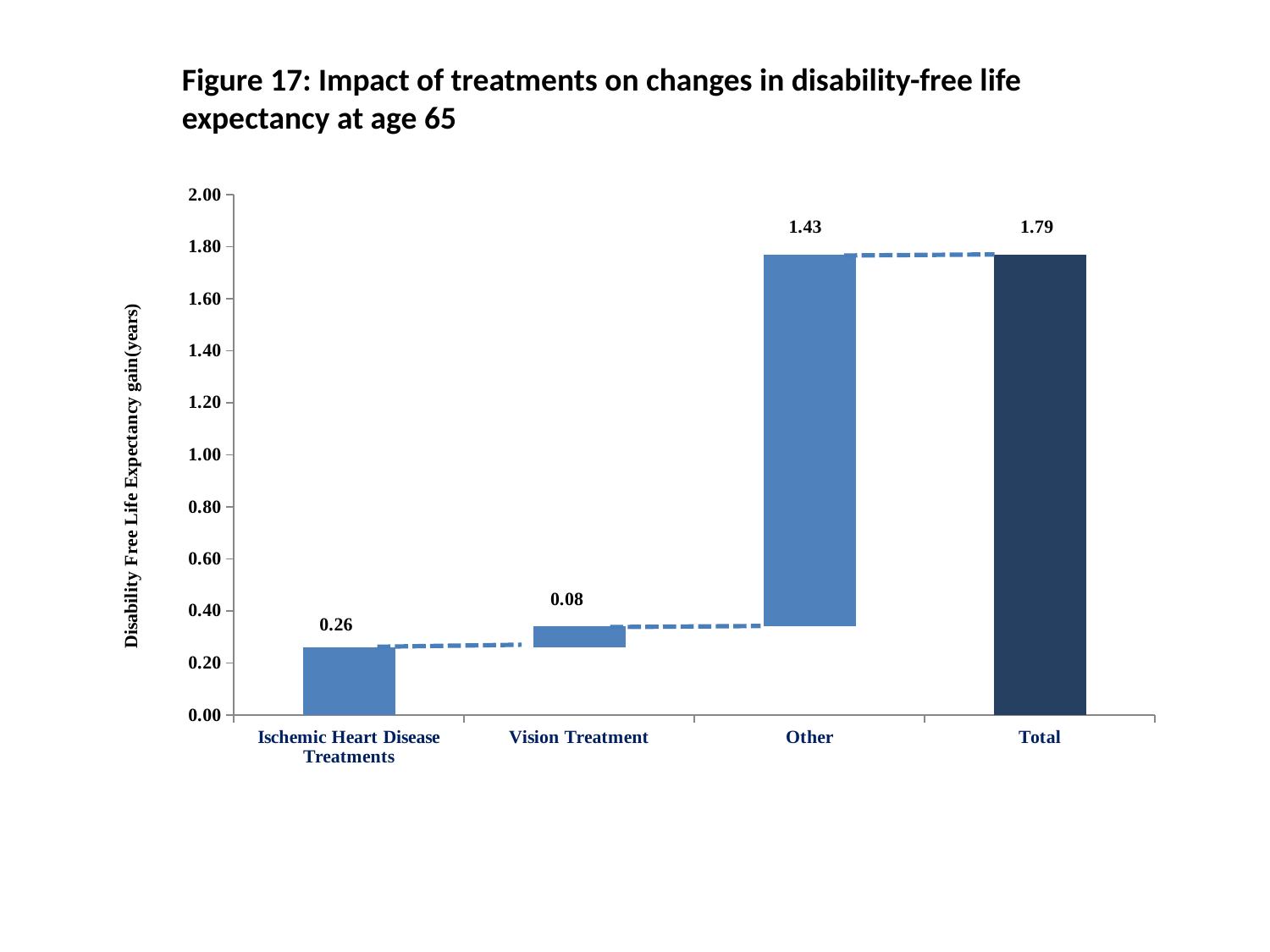
What is the value shown for Other? 1.43 Which category has the smallest value? Vision Treatment Which is larger, the value for Ischemic Heart Disease Treatments or the value for Vision Treatment? Ischemic Heart Disease Treatments What is the value shown for Ischemic Heart Disease Treatments? 0.26 Excluding the Total bar, which category has the largest value? Other What is the difference between the values for Other and Ischemic Heart Disease Treatments? 1.17 How many categories are shown on the x axis? 4 What kind of chart is shown on the slide? Bar chart What is the label of the vertical axis? Disability Free Life Expectancy gain(years) What is the value shown for the Total bar? 1.79 What is the difference between the values for Ischemic Heart Disease Treatments and Vision Treatment? 0.18 What is the value shown for Vision Treatment? 0.08